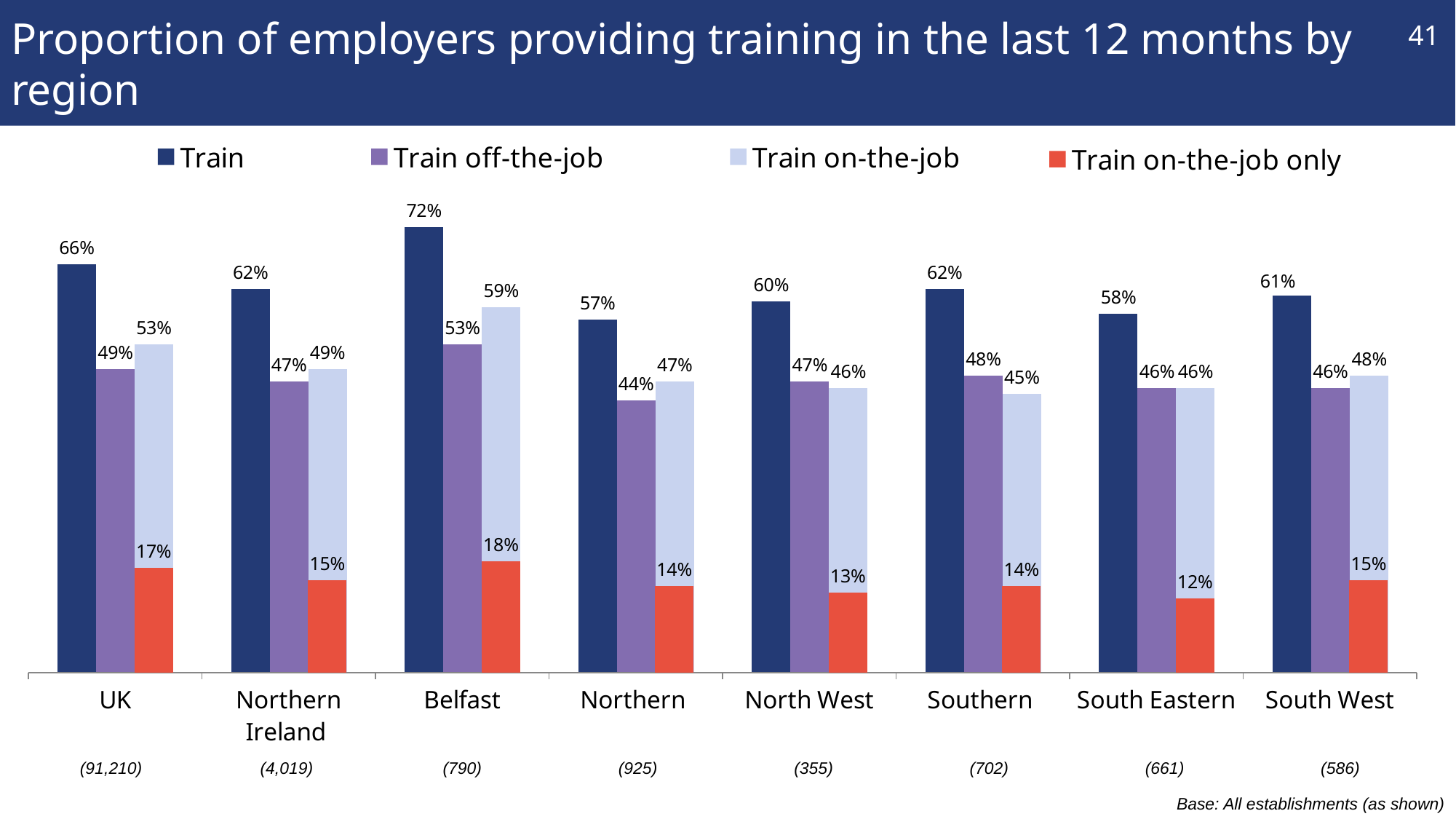
Which is larger: Train on-the-job in Belfast or Train on-the-job in Southern? Belfast Which region has the highest value for Train? Belfast What is the value for Train on-the-job only in South Eastern? 12% How many regions are shown on the x axis? 8 What kind of chart is shown on the slide? Bar chart What is the value for Train off-the-job in Northern? 44% How many series does the legend list? 4 What is the base (number of establishments) shown for Northern Ireland? 4,019 Which region has the lowest value for Train on-the-job only? South Eastern What is the value for Train on-the-job in the UK? 53% What is the difference between the Train value for Belfast and the Train value for Northern? 15% What is the value for Train in Belfast? 72%